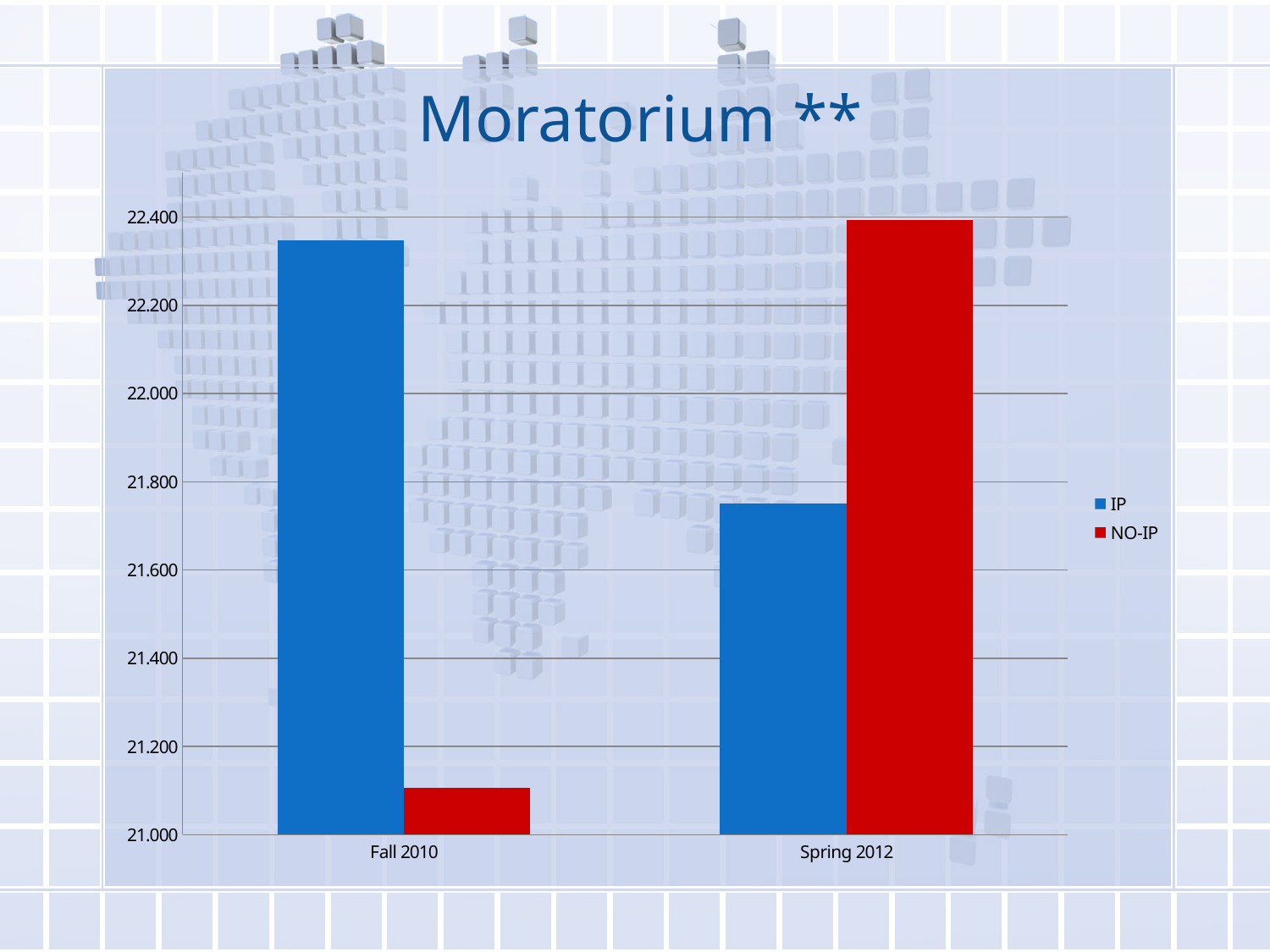
Is the IP value for Fall 2010 greater or less than 22.200? greater What kind of chart is shown on the slide? bar chart How many series does the legend list? 2 Is the IP value for Spring 2012 greater or less than 22.000? less What is the title of the chart? Moratorium ** For Fall 2010, which series has the larger value, IP or NO-IP? IP For Spring 2012, which series has the larger value, IP or NO-IP? NO-IP Which colour represents the NO-IP series? red Is the NO-IP value for Fall 2010 greater or less than 21.200? less Does the IP series rise or fall from Fall 2010 to Spring 2012? fall How many categories are shown on the x axis? 2